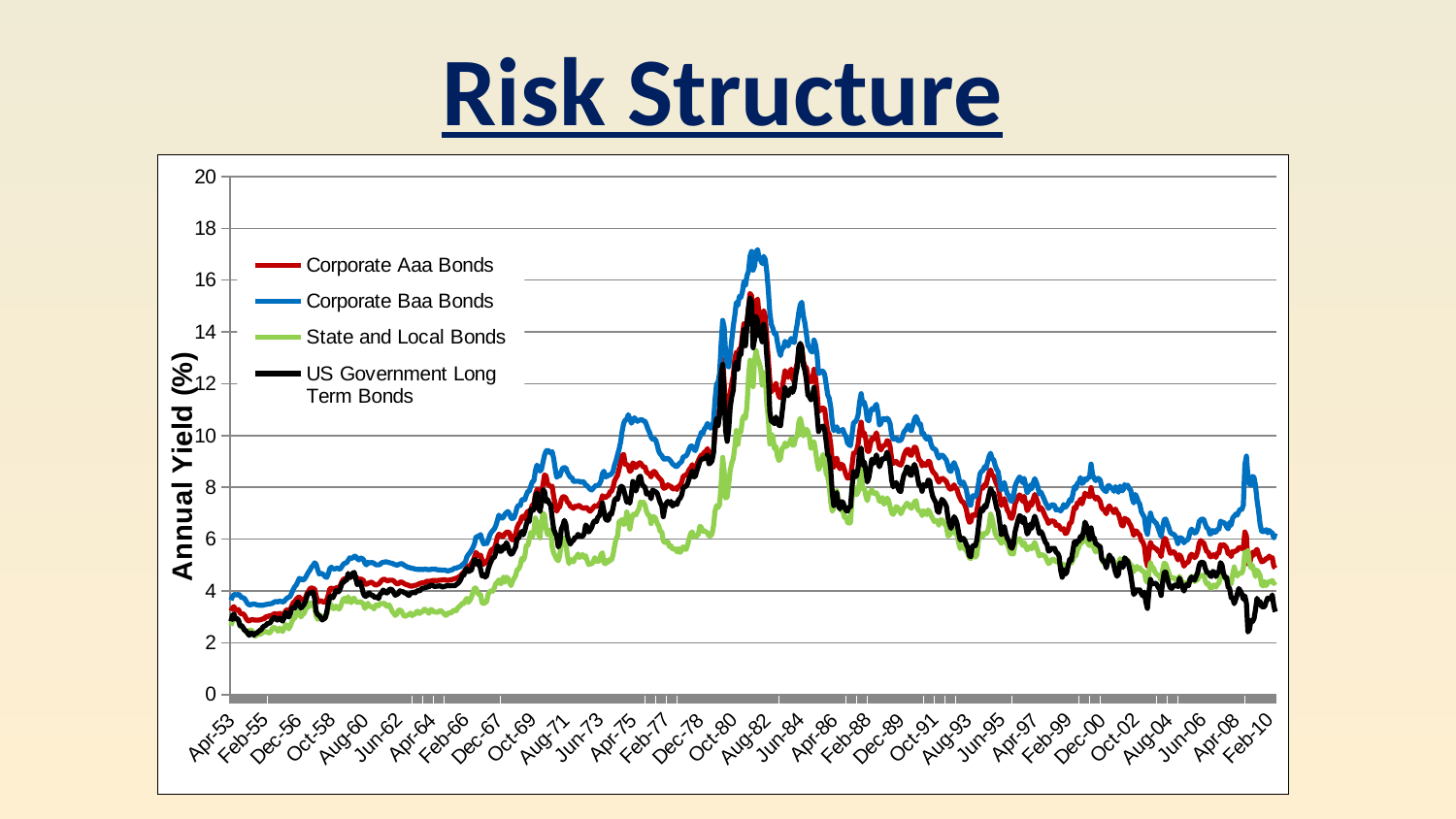
Is the value for Corporate Baa Bonds at Feb-10 greater or less than 8? less Is the value for US Government Long Term Bonds at Apr-53 greater or less than 4? less What is the label on the chart's vertical axis? Annual Yield (%) How many series does the chart's legend list? 4 What kind of chart is shown on the slide? line chart Which series reaches the highest peak on the chart? Corporate Baa Bonds Around Aug-82, which is larger: the value for Corporate Baa Bonds or the value for State and Local Bonds? Corporate Baa Bonds Is the peak value for Corporate Aaa Bonds greater or less than 14? greater Which series is the lowest around Aug-82? State and Local Bonds Do the yields generally rise or fall from Aug-82 to Feb-10? fall